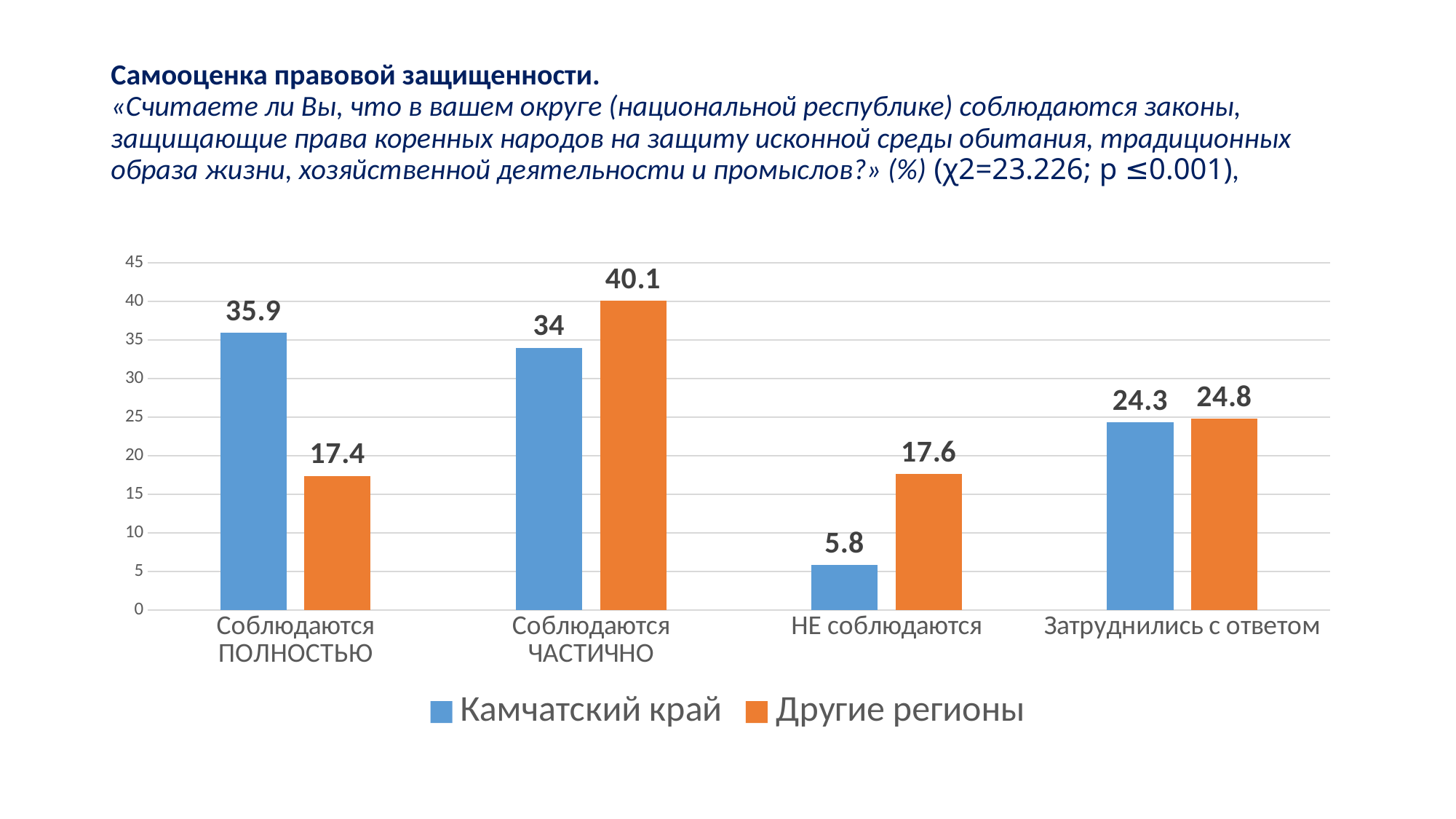
In the category НЕ соблюдаются, which series has the larger value, Камчатский край or Другие регионы? Другие регионы How many series does the legend list? 2 Which category has the lowest value for Другие регионы? Соблюдаются ПОЛНОСТЬЮ How many categories are shown on the x axis? 4 What is the value for Другие регионы in the category Затруднились с ответом? 24.8 What is the value for Камчатский край in the category Соблюдаются ПОЛНОСТЬЮ? 35.9 What is the value for Другие регионы in the category Соблюдаются ЧАСТИЧНО? 40.1 What is the value for Камчатский край in the category НЕ соблюдаются? 5.8 What kind of chart is shown on the slide? bar chart What is the difference between Камчатский край and Другие регионы in the category Соблюдаются ПОЛНОСТЬЮ? 18.5 Is the value for Камчатский край in the category Соблюдаются ЧАСТИЧНО greater or less than 30? greater Which category has the highest value for Камчатский край? Соблюдаются ПОЛНОСТЬЮ